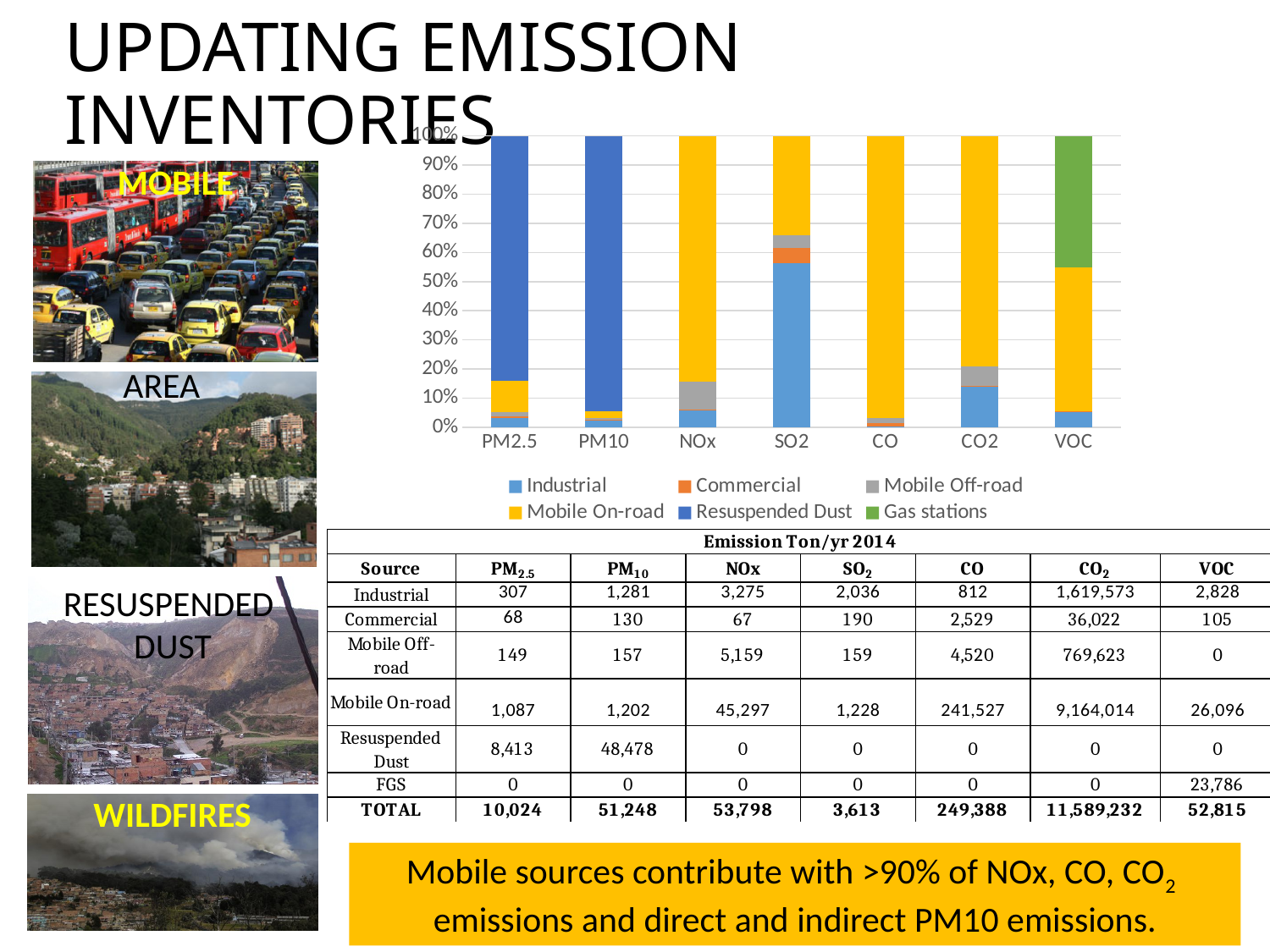
Which series is shown in green in the chart? Gas stations Is the Industrial share of the SO2 bar greater or less than 50%? greater Is the Gas stations share of the VOC bar greater or less than 40%? greater Is the Mobile On-road share of the NOx bar greater or less than 80%? greater Which series is shown in yellow in the chart? Mobile On-road What kind of chart is shown on the slide? Stacked bar chart How many pollutant categories are shown along the x axis of the chart? 7 Which pollutant has the largest Industrial share in the chart? SO2 Is the Industrial share larger for SO2 or for CO? SO2 How many series does the chart legend list? 6